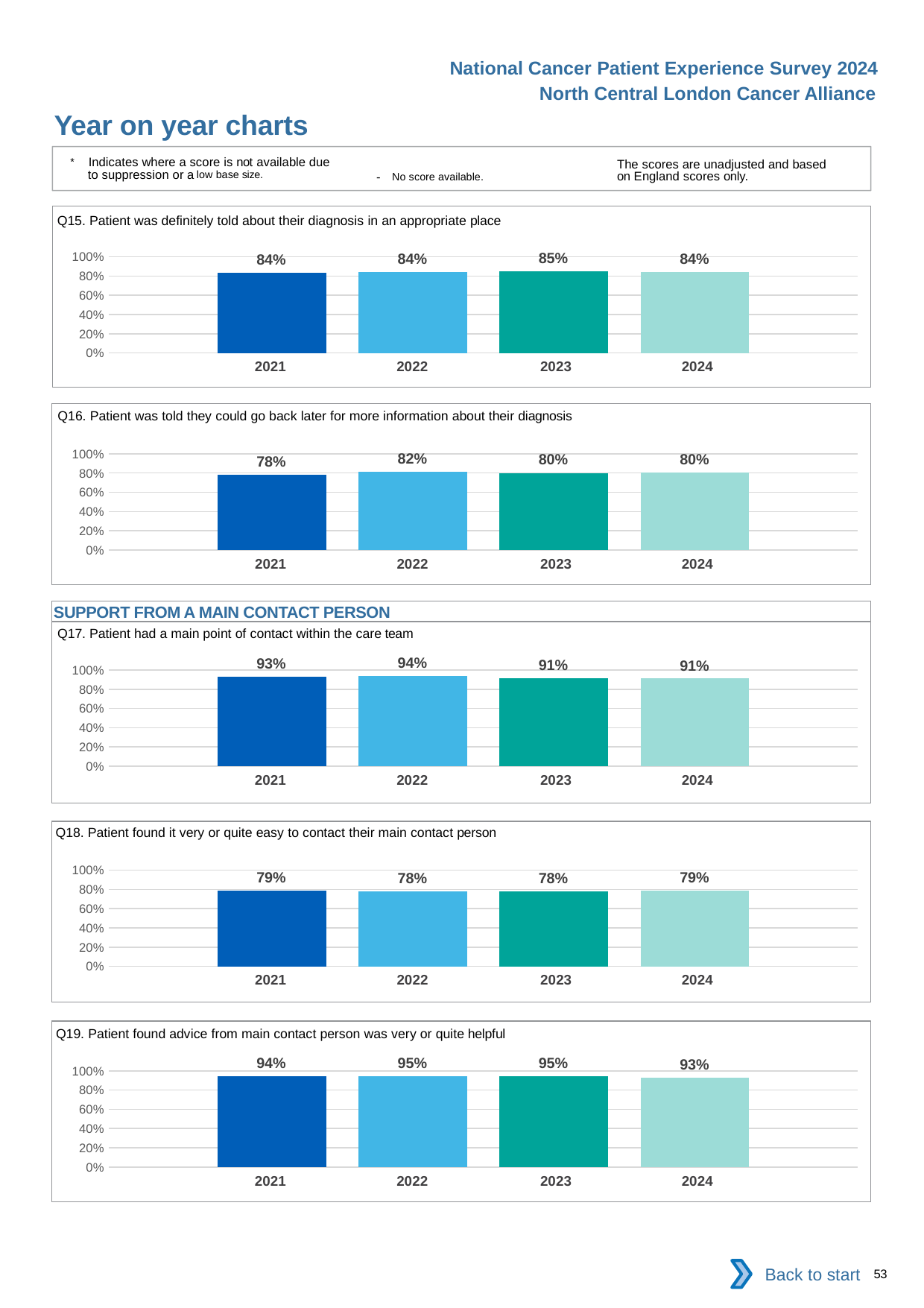
How many years are shown on the x axis of the Q15 chart? 4 In the Q17 chart, which year has the highest value? 2022 In the Q19 chart (patient found advice from main contact person was very or quite helpful), which is larger, the value for 2021 or the value for 2024? 2021 In the Q19 chart, what is the value for 2024? 93% In the Q15 chart (patient was definitely told about their diagnosis in an appropriate place), what is the value for 2023? 85% In the Q18 chart (patient found it very or quite easy to contact their main contact person), what is the value for 2024? 79% In the Q17 chart, is the value for 2023 greater or less than 80%? greater In the Q17 chart (patient had a main point of contact within the care team), what is the value for 2022? 94% In the Q16 chart (patient was told they could go back later for more information about their diagnosis), which year has the lowest value? 2021 What is the section heading shown above the Q17 chart? SUPPORT FROM A MAIN CONTACT PERSON In the Q16 chart, what is the difference between the 2022 value and the 2021 value? 4 percentage points What type of chart is the Q18 chart? Bar chart